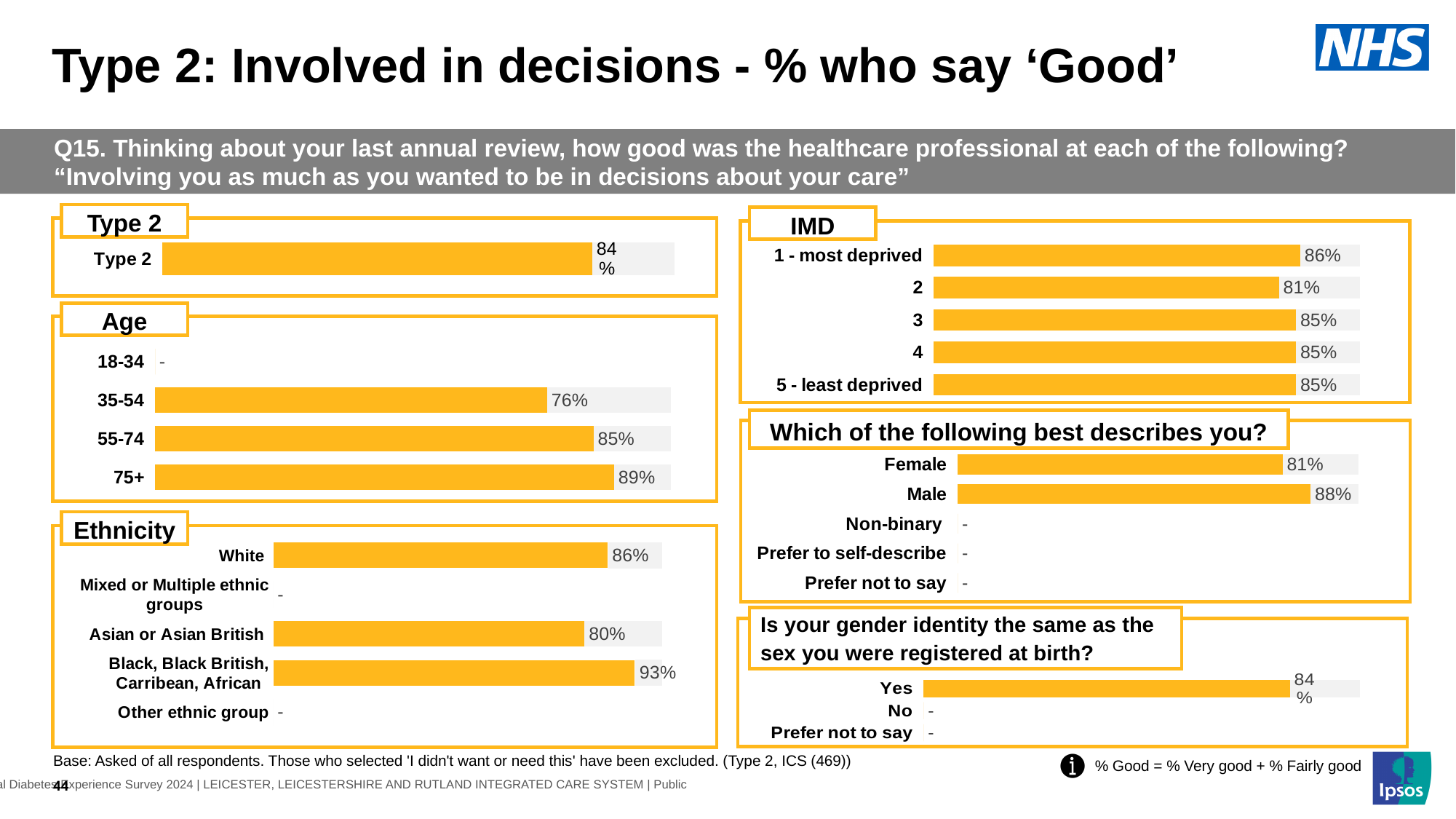
In the Age chart, what is the value for 35-54? 76% In the IMD chart, which category has the lowest value? 2 In the Type 2 chart, what is the value for Type 2? 84% In the IMD chart, how many categories are shown? 5 In the Ethnicity chart, which ethnic group has the highest value? Black, Black British, Carribean, African In the IMD chart, what is the value for 1 - most deprived? 86% In the 'Is your gender identity the same as the sex you were registered at birth?' chart, what is the value for Yes? 84% In the 'Which of the following best describes you?' chart, which is larger, Female or Male? Male In the Age chart, which age group has the highest value? 75+ In the Ethnicity chart, what is the value for Asian or Asian British? 80% In the 'Which of the following best describes you?' chart, what is the difference between the values for Male and Female? 7 percentage points In the Age chart, what is the difference between the values for 75+ and 55-74? 4 percentage points